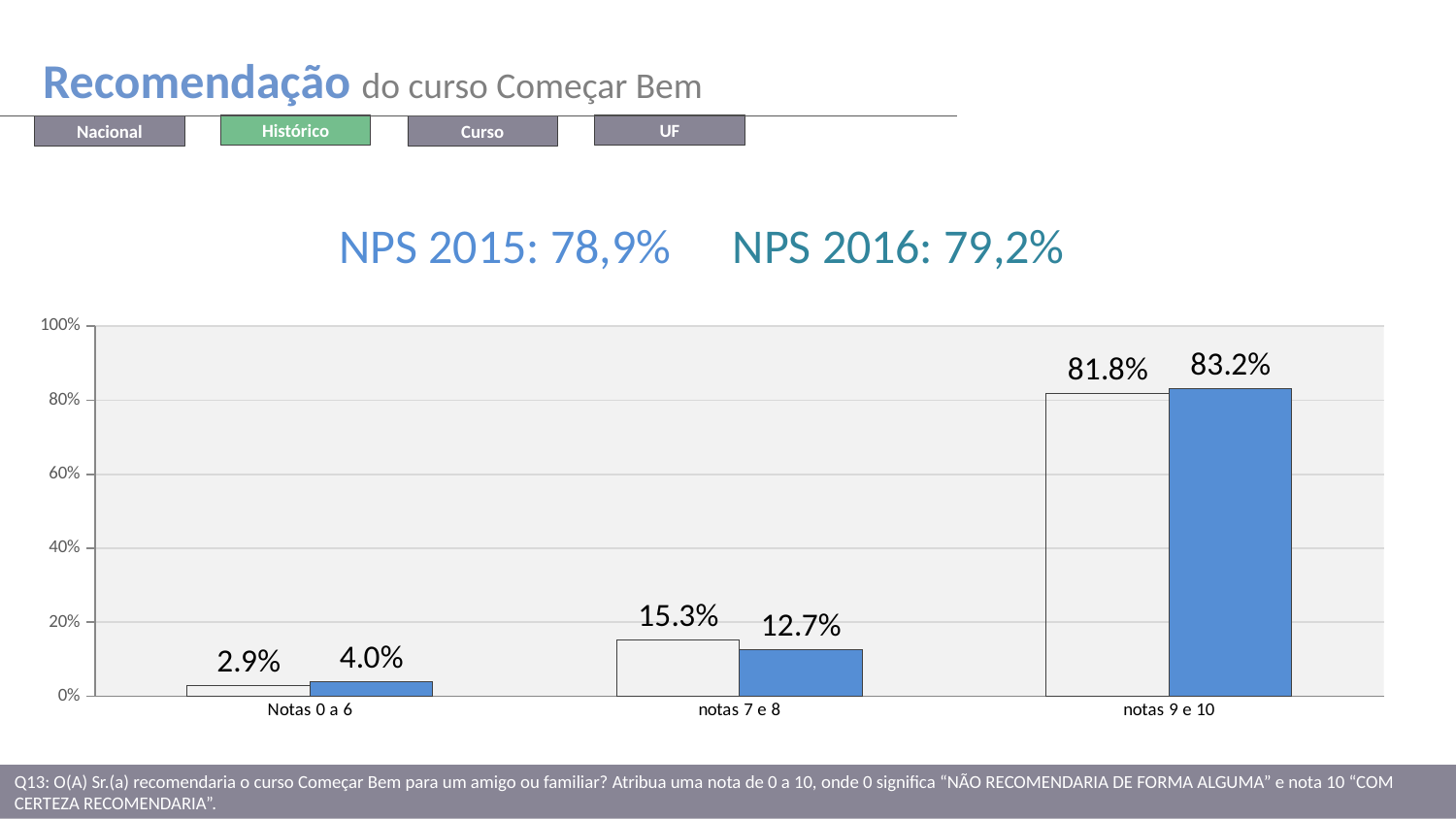
What is the value of the white bar for 'notas 7 e 8'? 15.3% What kind of chart is shown on the slide? bar chart What NPS value is shown for 2016 above the chart? 79,2% What is the value of the blue bar for 'notas 9 e 10'? 83.2% What is the difference between the blue bar and the white bar for 'notas 9 e 10'? 1.4% Which category has the highest blue bar? notas 9 e 10 What is the value of the blue bar for 'Notas 0 a 6'? 4.0% What is the value of the white bar for 'Notas 0 a 6'? 2.9% How many categories are shown on the x axis? 3 For 'notas 7 e 8', which bar is larger, the white bar or the blue bar? the white bar Which category has the lowest white bar? Notas 0 a 6 Is the value of the white bar for 'notas 9 e 10' greater or less than 80%? greater